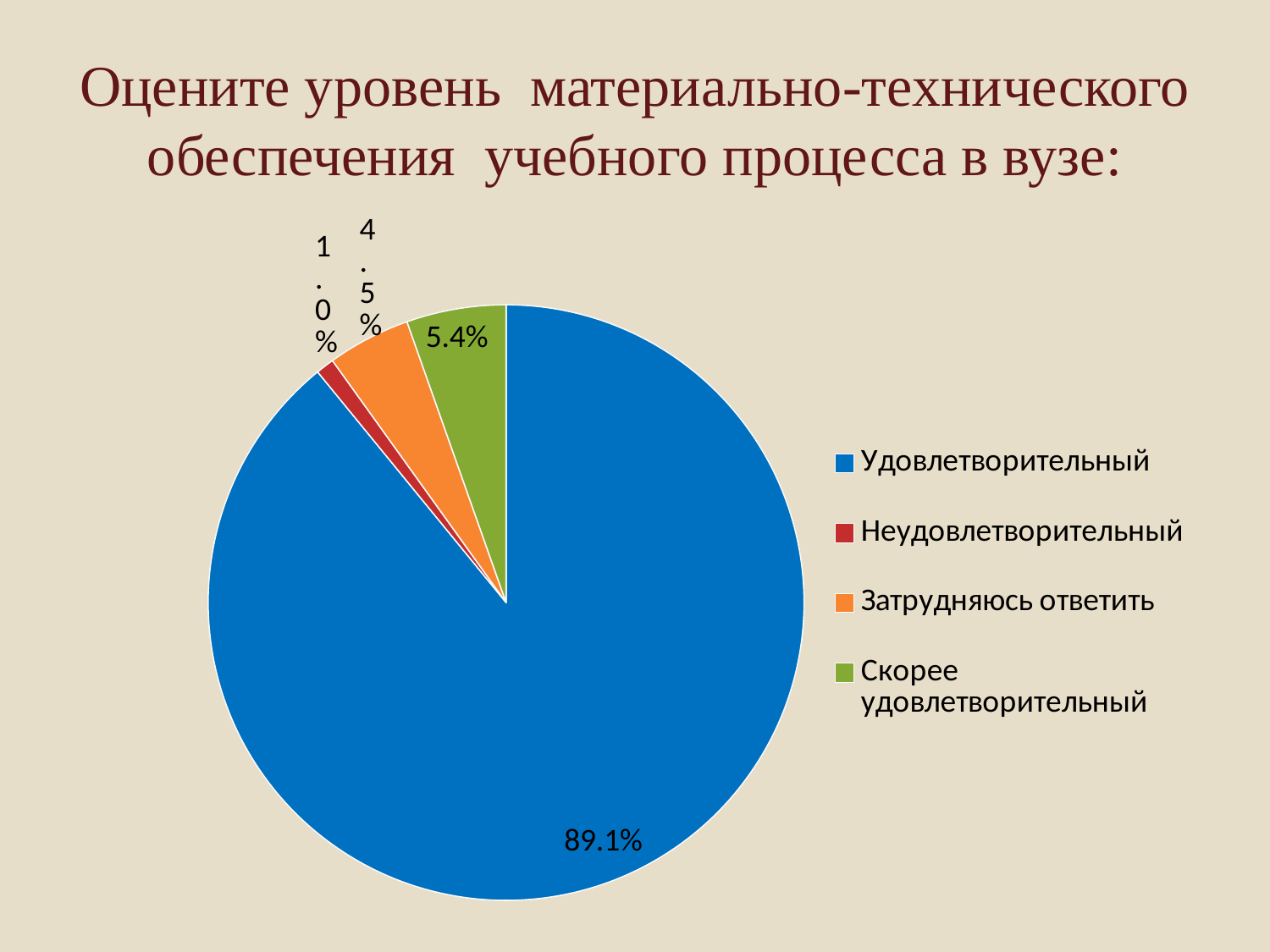
Which category has the smallest slice of the pie? Неудовлетворительный What is the difference between the shares for "Затрудняюсь ответить" and "Неудовлетворительный"? 3.5% What colour is the slice for "Затрудняюсь ответить"? orange What share of respondents answered "Скорее удовлетворительный"? 5.4% What share of respondents answered "Удовлетворительный"? 89.1% How many categories does the pie chart show? 4 Which is larger: the share for "Скорее удовлетворительный" or the share for "Затрудняюсь ответить"? Скорее удовлетворительный What kind of chart is shown on the slide? pie chart What is the difference between the shares for "Удовлетворительный" and "Скорее удовлетворительный"? 83.7% What share of respondents answered "Неудовлетворительный"? 1.0% What share of respondents answered "Затрудняюсь ответить"? 4.5% Which category has the largest slice of the pie? Удовлетворительный